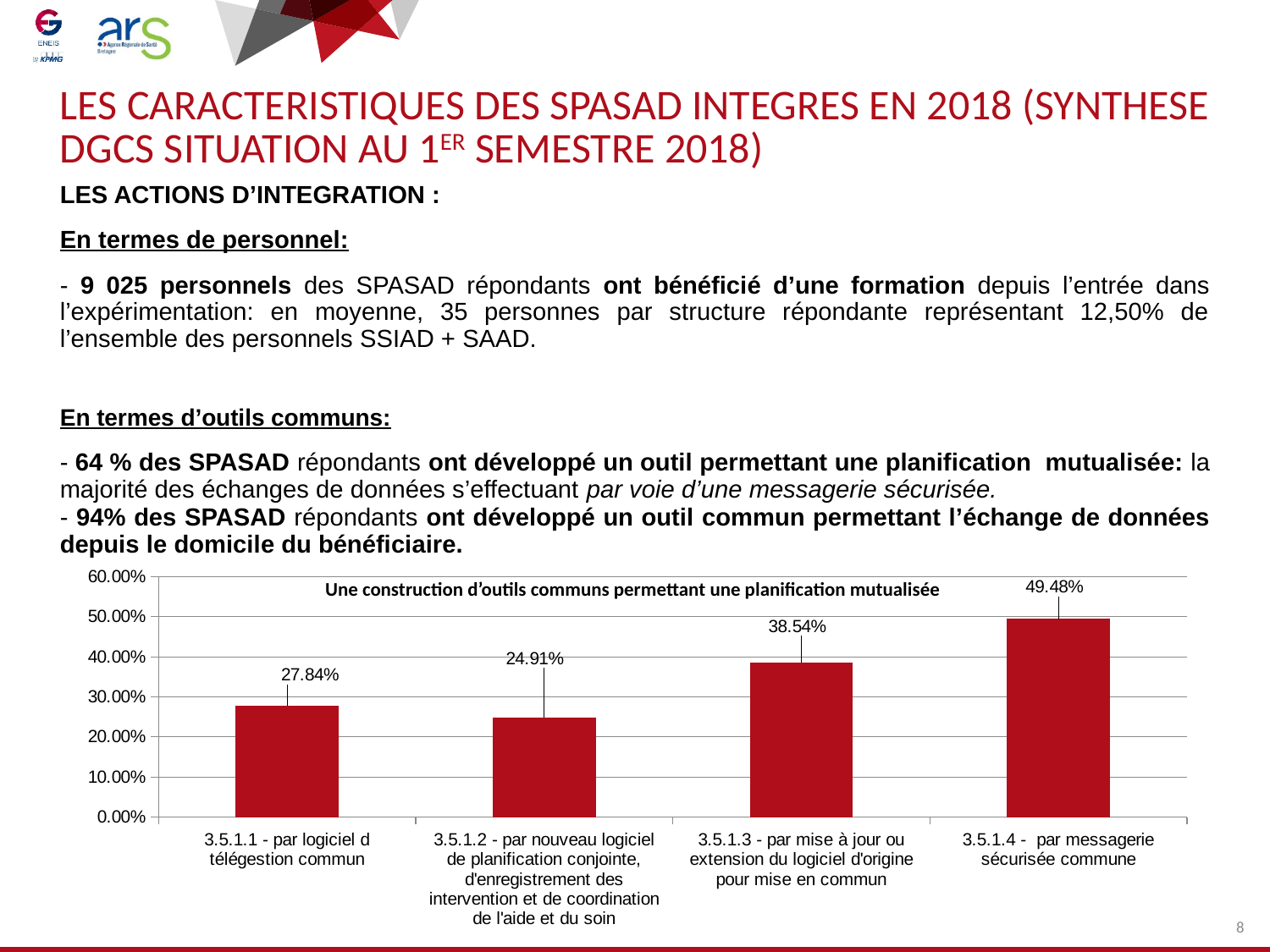
What is the value for '3.5.1.1 - par logiciel d télégestion commun'? 27.84% What is the value for '3.5.1.4 - par messagerie sécurisée commune'? 49.48% What is the title of the chart? Une construction d'outils communs permettant une planification mutualisée Is the value for '3.5.1.4 - par messagerie sécurisée commune' greater or less than 40.00%? greater What is the difference between the values for '3.5.1.4 - par messagerie sécurisée commune' and '3.5.1.1 - par logiciel d télégestion commun'? 21.64% Which category has the highest value? 3.5.1.4 - par messagerie sécurisée commune How many categories are shown in the chart? 4 Which is larger: the value for '3.5.1.3 - par mise à jour ou extension du logiciel d'origine pour mise en commun' or for '3.5.1.2 - par nouveau logiciel de planification conjointe'? 3.5.1.3 - par mise à jour ou extension du logiciel d'origine pour mise en commun What is the difference between the values for '3.5.1.3 - par mise à jour ou extension du logiciel d'origine pour mise en commun' and '3.5.1.2 - par nouveau logiciel de planification conjointe'? 13.63% Which category has the lowest value? 3.5.1.2 - par nouveau logiciel de planification conjointe, d'enregistrement des intervention et de coordination de l'aide et du soin What is the value for '3.5.1.3 - par mise à jour ou extension du logiciel d'origine pour mise en commun'? 38.54% What kind of chart is shown on the slide? bar chart